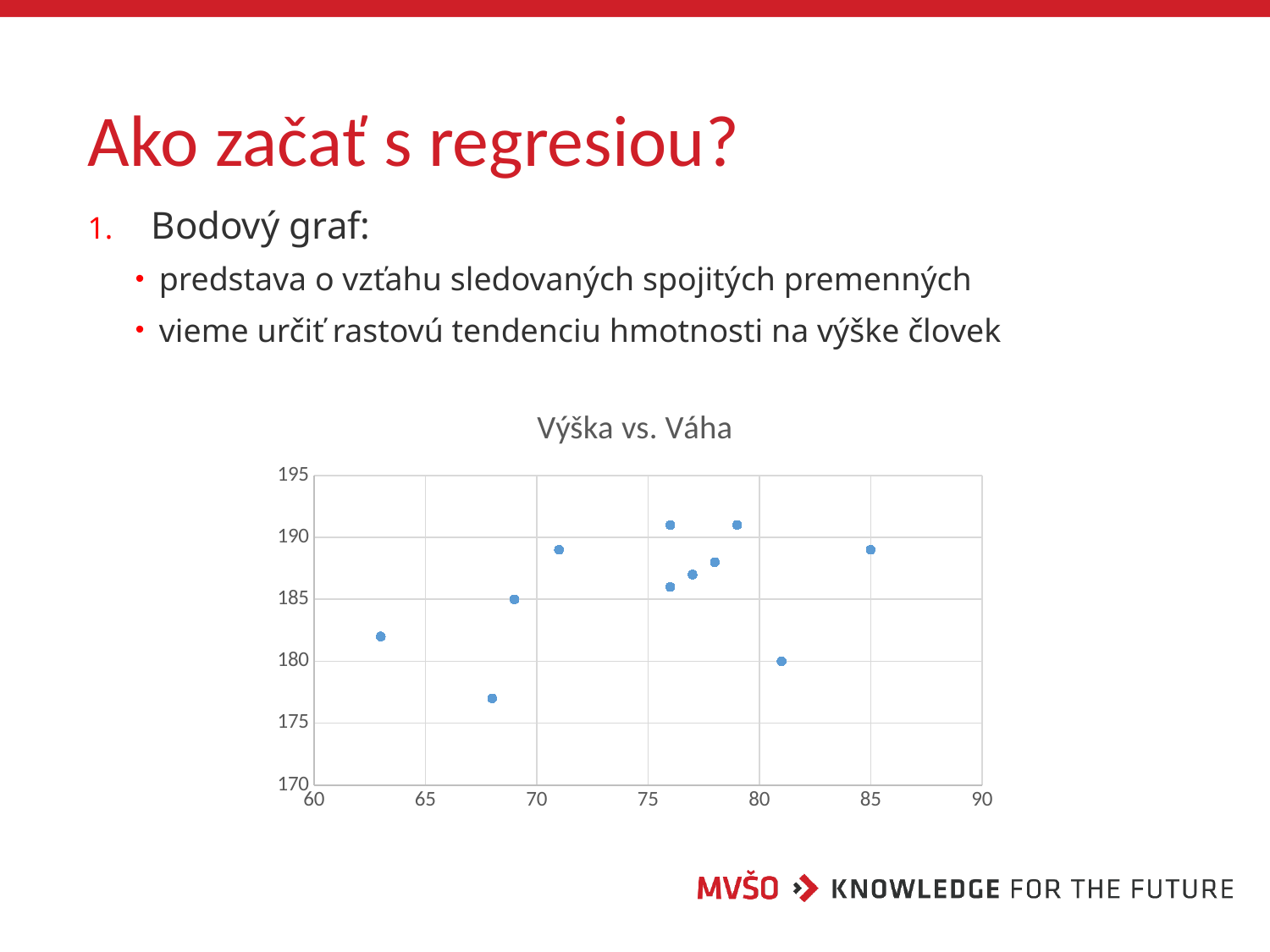
Is the y value of the point near x = 78 greater or less than 185? greater Is the y value of the rightmost point (near x = 85) greater or less than 185? greater What is the title of the chart? Výška vs. Váha What kind of chart is shown on the slide? scatter chart Do the values generally rise or fall as you move from left to right along the x axis? rise What is the maximum value shown on the y axis? 195 Is the y value of the point near x = 68 greater or less than 180? less Which point has the lowest y value: the one near x = 68 or the one near x = 63? the one near x = 68